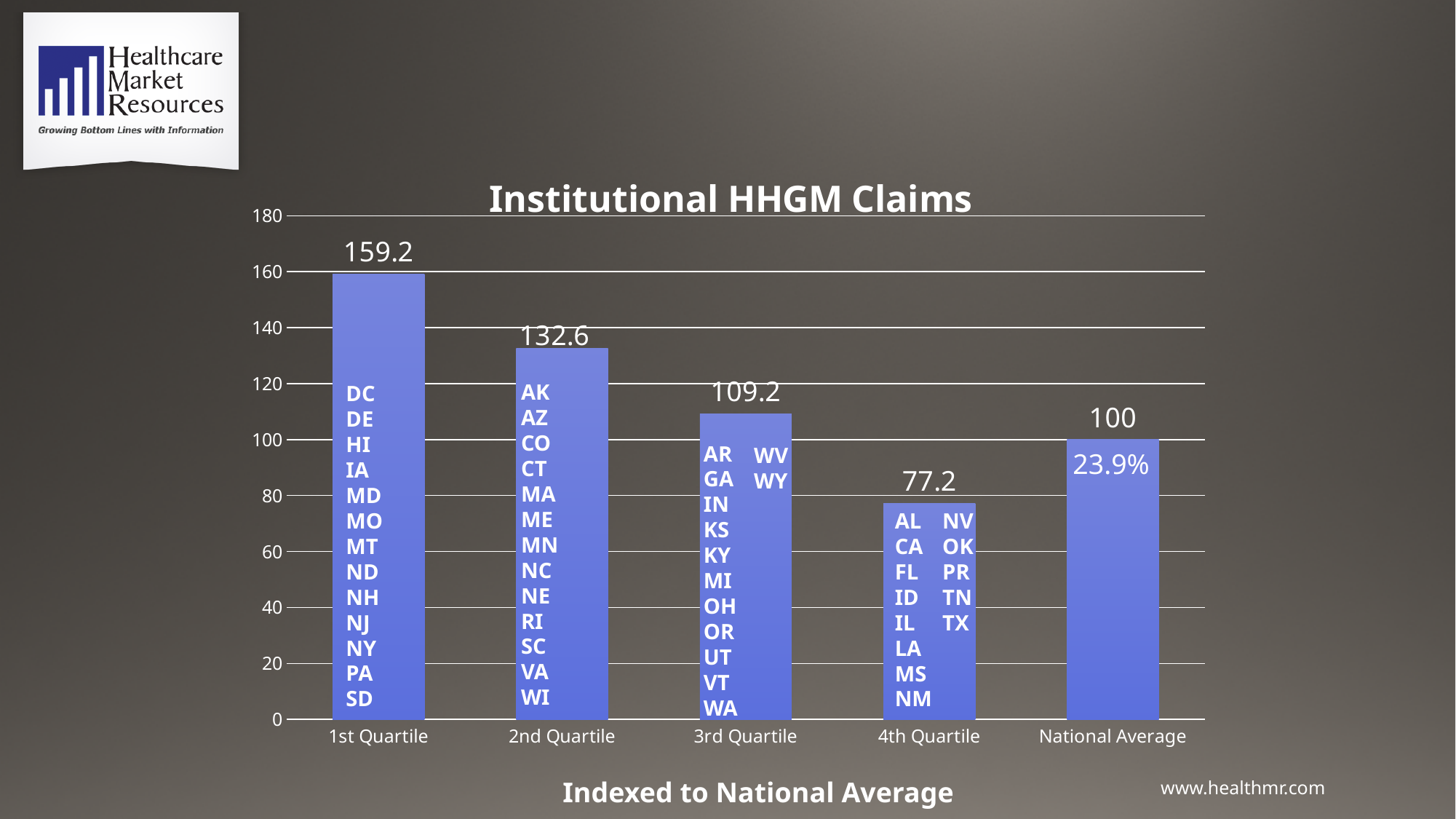
How many categories are shown on the x axis? 5 Which category has the lowest value? 4th Quartile Which is larger, the 3rd Quartile value or the National Average value? 3rd Quartile What is the title of the chart? Institutional HHGM Claims What is the value for the 1st Quartile? 159.2 What is the value for the 2nd Quartile? 132.6 What is the value for the National Average? 100 Which category has the highest value? 1st Quartile What is the value for the 4th Quartile? 77.2 What is the value for the 3rd Quartile? 109.2 What is the difference between the 1st Quartile and the 2nd Quartile values? 26.6 What kind of chart is shown on the slide? Bar chart